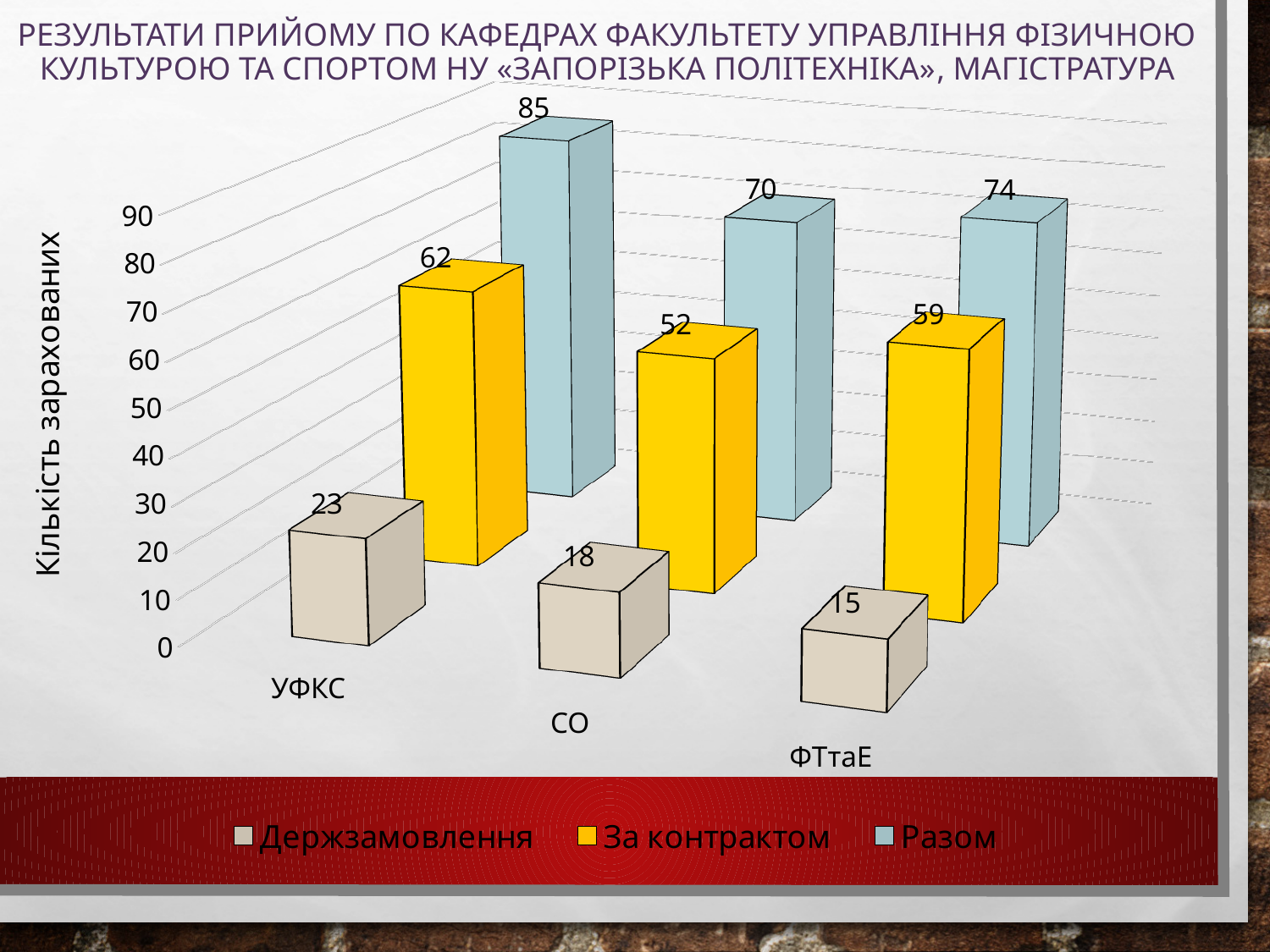
What is the difference between the Разом values for УФКС and СО? 15 What is the value for За контрактом at СО? 52 How many series does the legend list? 3 What is the value for Держзамовлення at УФКС? 23 What is the value for Разом at ФТтаЕ? 74 Which category has the highest value for Разом? УФКС Which category has the lowest value for Держзамовлення? ФТтаЕ Which is larger: За контрактом at ФТтаЕ or За контрактом at СО? За контрактом at ФТтаЕ Do the Держзамовлення values rise or fall from УФКС to ФТтаЕ? fall What is the label of the vertical axis? Кількість зарахованих What kind of chart is shown on the slide? bar chart How many categories are shown on the x axis? 3